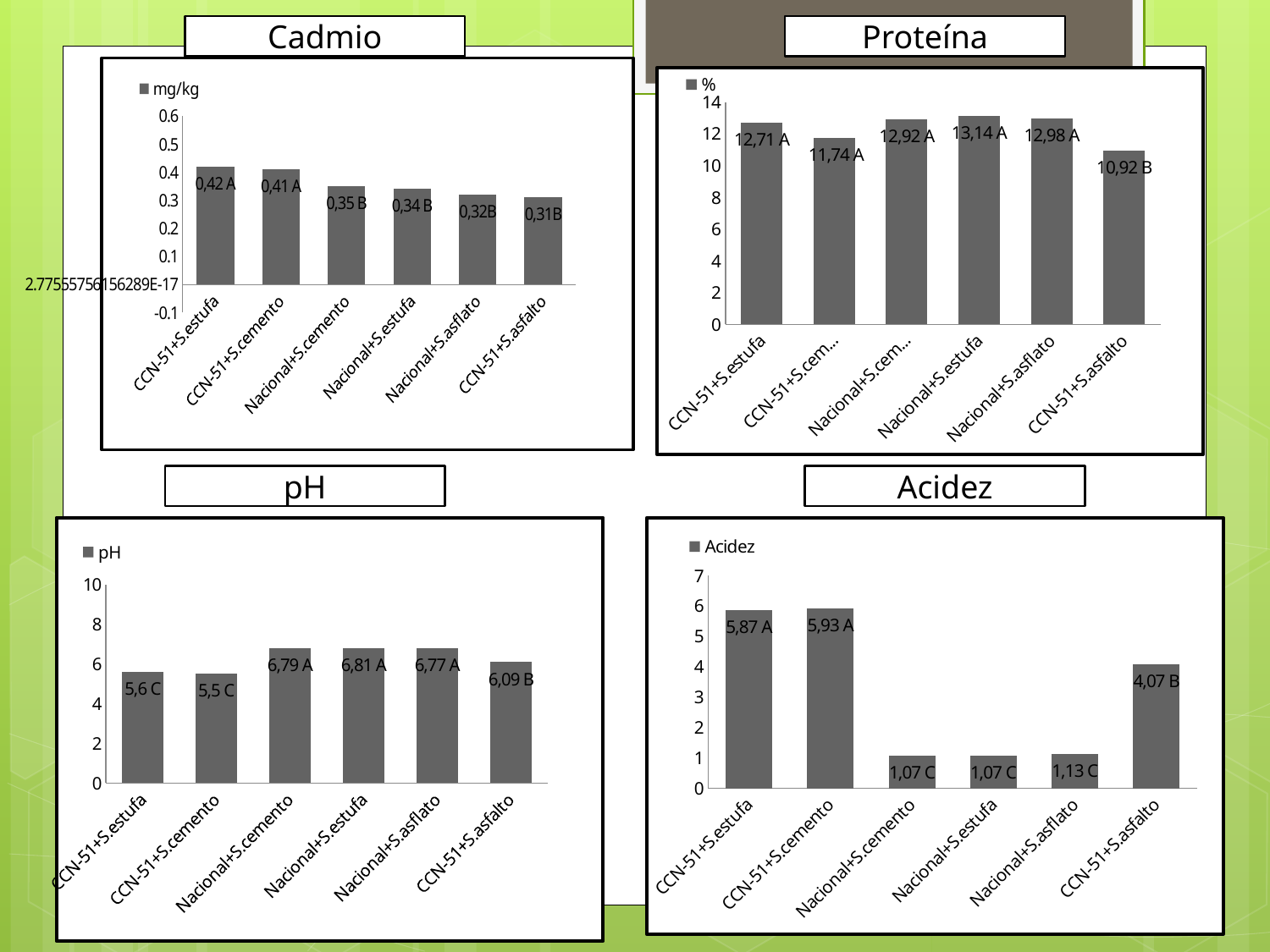
In the Cadmio chart, which category has the lowest value? CCN-51+S.asfalto In the Acidez chart, what is the difference between the values for CCN-51+S.cemento and CCN-51+S.estufa? 0,06 In the Proteína chart, is the value for CCN-51+S.asfalto greater or less than 12? less In the Cadmio chart, what is the data label for CCN-51+S.estufa? 0,42 A In the Acidez chart, what is the data label for CCN-51+S.cemento? 5,93 A In the Acidez chart, which category has the highest value? CCN-51+S.cemento In the pH chart, what is the data label for CCN-51+S.cemento? 5,5 C What type of chart is the pH chart? bar chart How many categories are shown in the Acidez chart? 6 In the Proteína chart, which category has the lowest value? CCN-51+S.asfalto In the Proteína chart, what is the data label for Nacional+S.estufa? 13,14 A In the pH chart, which is larger, the value for Nacional+S.estufa or CCN-51+S.asfalto? Nacional+S.estufa